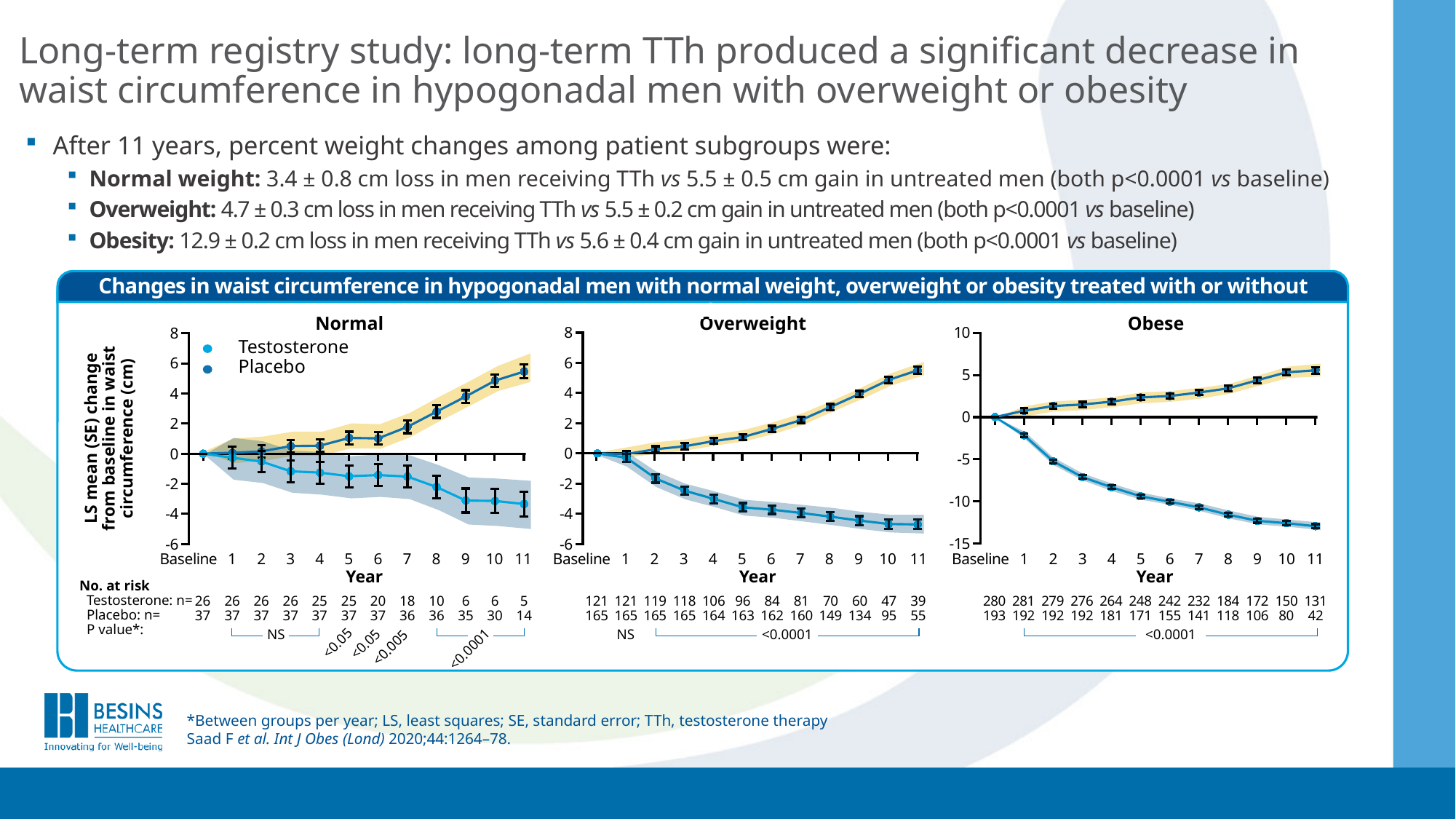
In the Overweight chart, does the Placebo line rise or fall from Baseline to year 11? rise How many series does the legend on the Normal chart list? 2 In the Overweight chart, is the Placebo value at year 11 greater or less than 4? greater In the Obese chart, does the Testosterone line rise or fall from Baseline to year 11? fall In the Normal chart, what is the number at risk for Testosterone at year 11? 5 How many time points (including Baseline) are plotted along the x axis of the Overweight chart? 12 In the Obese chart, what is the number at risk for Placebo at Baseline? 193 What kind of chart is the Normal chart? Line chart In the Overweight chart, which series has the higher value at year 11, Testosterone or Placebo? Placebo What is the y-axis label shared by the three charts? LS mean (SE) change from baseline in waist circumference (cm) In the Obese chart, is the Testosterone value at year 11 greater or less than -10? less In the Overweight chart, what is the difference between the Placebo and Testosterone numbers at risk at Baseline? 44